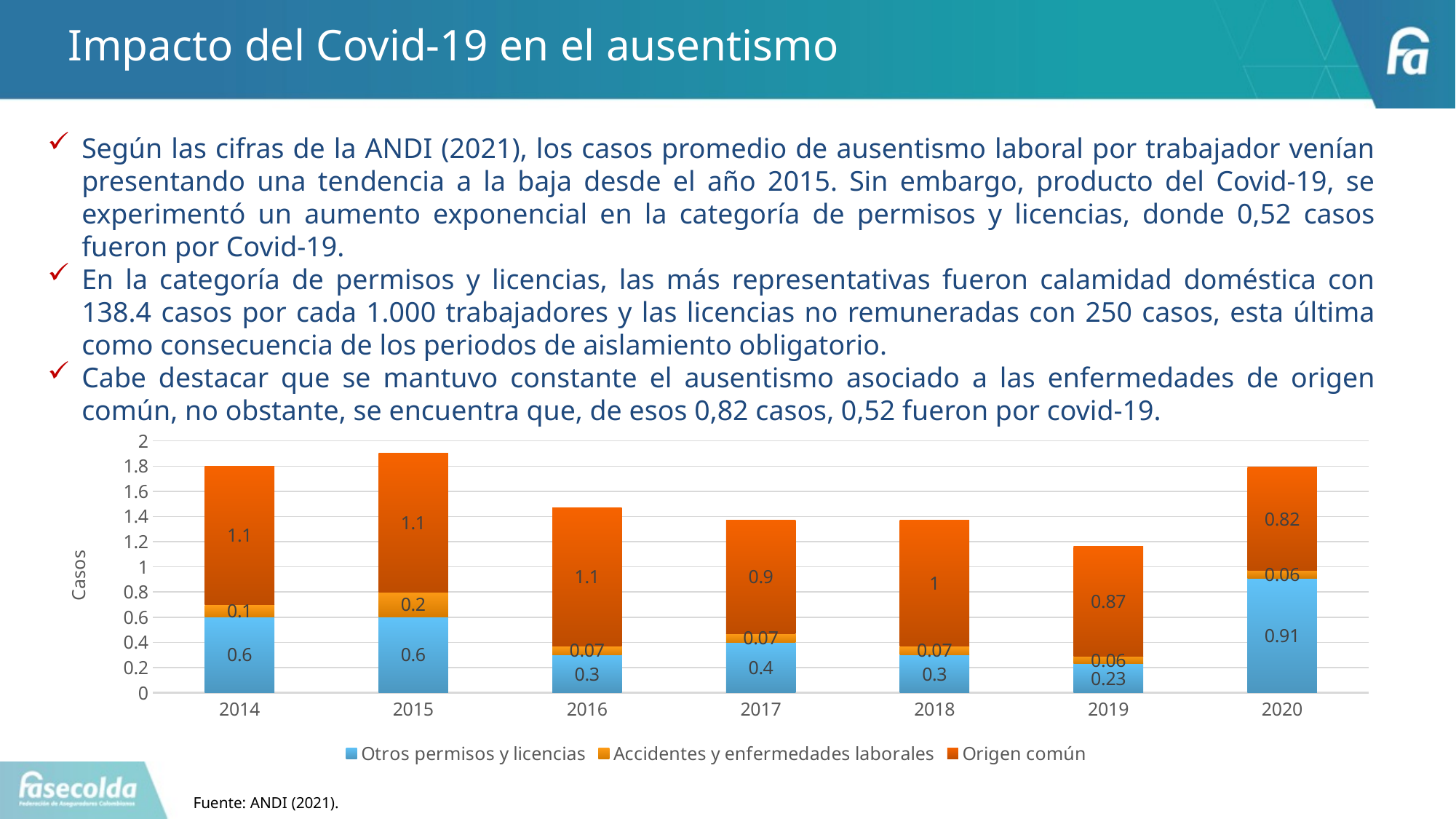
Which year has the larger value for Origen común, 2017 or 2018? 2018 What is the value for Accidentes y enfermedades laborales in 2015? 0.2 How many years are shown on the x axis of the chart? 7 In which year is the value for Otros permisos y licencias highest? 2020 What is the value for Origen común in 2019? 0.87 Is the total of the stacked bar for 2016 greater or less than 1.4? greater What is the value for Otros permisos y licencias in 2020? 0.91 What is the difference between the Otros permisos y licencias values for 2020 and 2019? 0.68 In which year is the value for Otros permisos y licencias lowest? 2019 How many series does the chart legend list? 3 What is the total of the stacked bar for 2014? 1.8 What type of chart is shown on the slide? Stacked bar chart